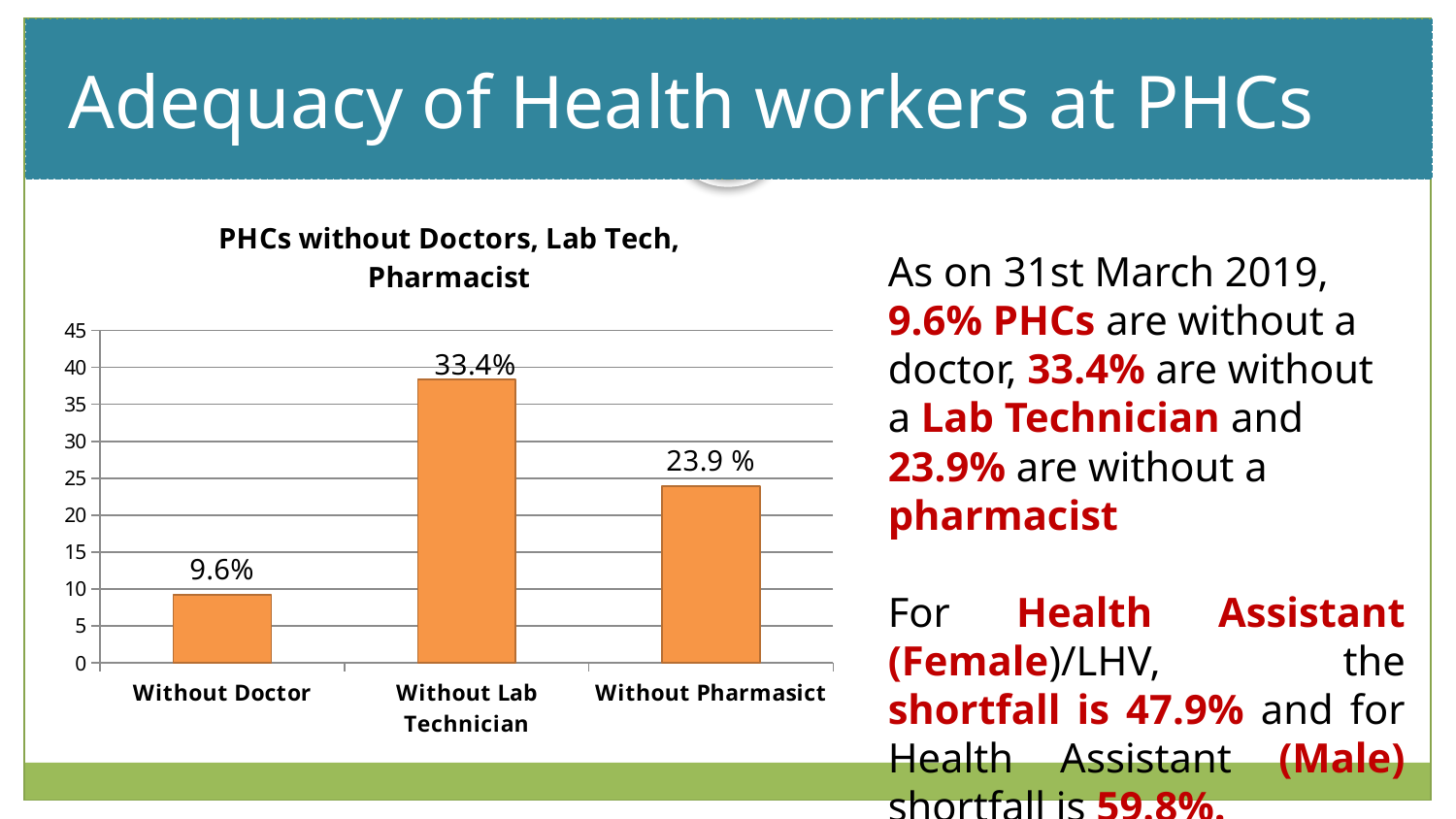
What is the value for Without Pharmasict in the chart? 23.9 % Which is larger, the value for Without Pharmasict or the value for Without Doctor? Without Pharmasict Which category has the highest value in the chart? Without Lab Technician What kind of chart is shown on the slide? bar chart What is the value for Without Doctor in the chart? 9.6% How many categories are shown in the chart? 3 Which category has the lowest value in the chart? Without Doctor Is the value for Without Lab Technician greater or less than 30? greater What is the difference between the values for Without Lab Technician and Without Doctor? 23.8% What is the title of the chart? PHCs without Doctors, Lab Tech, Pharmacist What is the value for Without Lab Technician in the chart? 33.4% What is the difference between the values for Without Lab Technician and Without Pharmasict? 9.5%